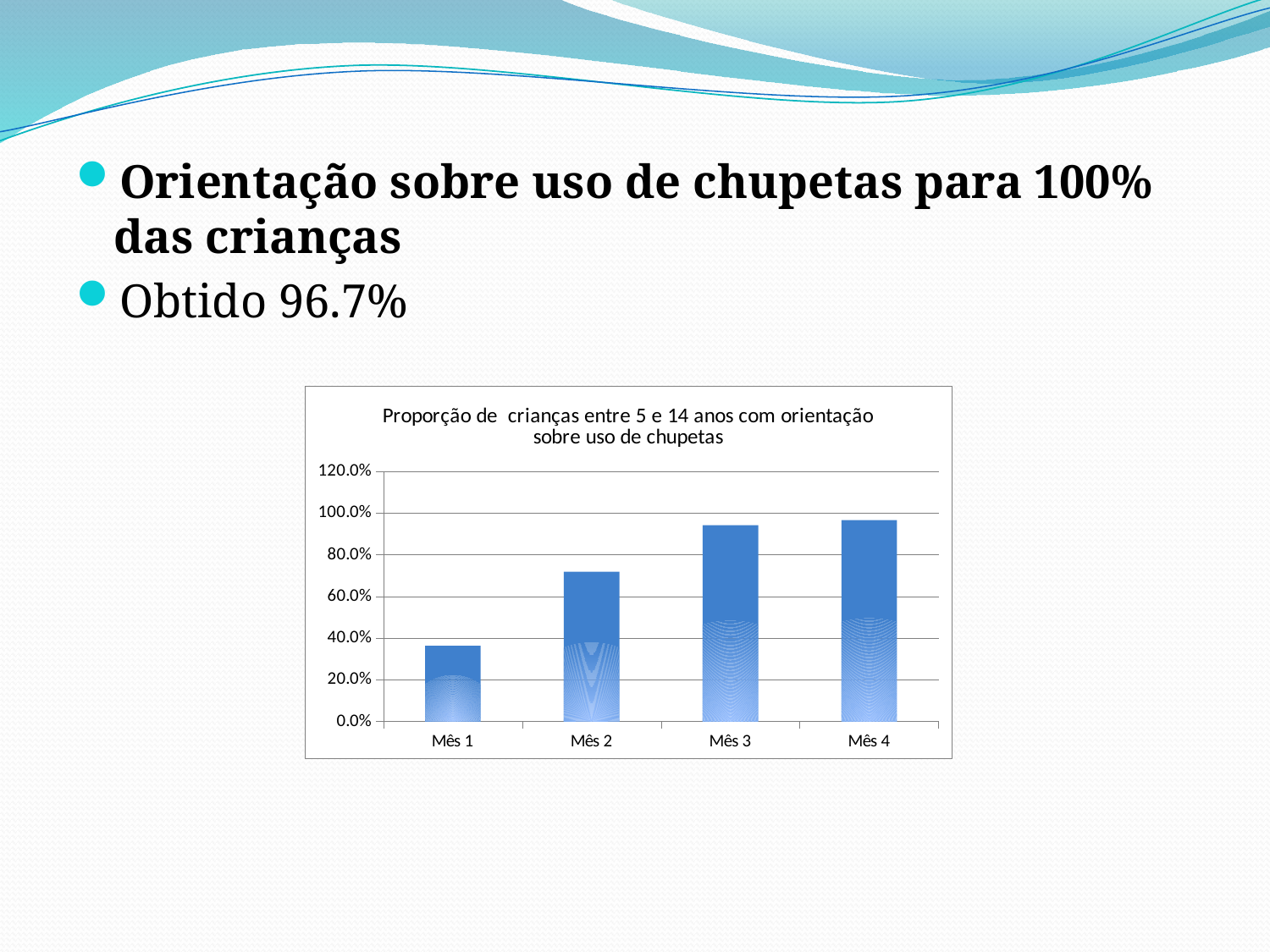
What is the title of the chart? Proporção de crianças entre 5 e 14 anos com orientação sobre uso de chupetas How many months (categories) are shown on the x axis of the chart? 4 Is the value for Mês 2 greater or less than 60.0%? greater Is the value for Mês 4 greater or less than 100.0%? less Is the value for Mês 1 greater or less than 40.0%? less Which is larger, the value for Mês 1 or the value for Mês 2? Mês 2 What kind of chart is shown on the slide? bar chart Do the values rise or fall from Mês 1 to Mês 4? rise What is the highest value shown on the chart's y axis? 120.0% Which month has the lowest proportion in the chart? Mês 1